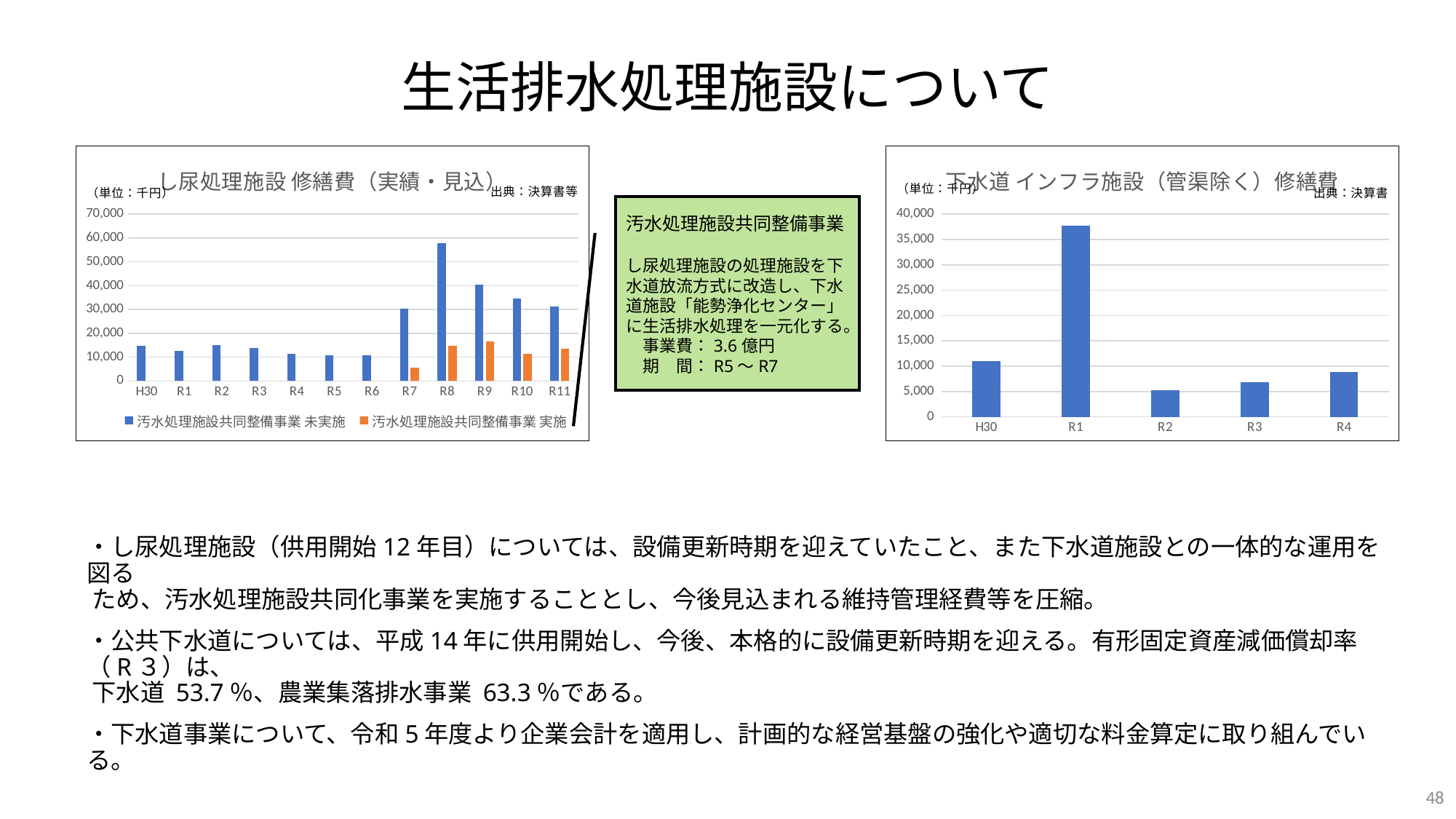
In the left chart (し尿処理施設 修繕費), is the 実施 value for R7 greater or less than 10,000? less How many categories are shown on the x axis of the left chart (し尿処理施設 修繕費)? 12 How many series does the legend of the left chart (し尿処理施設 修繕費) list? 2 In the left chart (し尿処理施設 修繕費), is the 未実施 value for R8 greater or less than 50,000? greater In the right chart (下水道 インフラ施設（管渠除く）修繕費), is the value for R1 greater or less than 35,000? greater How many categories are shown on the x axis of the right chart (下水道 インフラ施設（管渠除く）修繕費)? 5 In the right chart (下水道 インフラ施設（管渠除く）修繕費), which year has the lowest value? R2 In the left chart (し尿処理施設 修繕費), which year has the highest value for 汚水処理施設共同整備事業 実施? R9 In the left chart (し尿処理施設 修繕費), which year has the highest value for 汚水処理施設共同整備事業 未実施? R8 In the right chart (下水道 インフラ施設（管渠除く）修繕費), which year has the highest value? R1 What kind of chart is the left chart titled し尿処理施設 修繕費（実績・見込）? bar chart In the left chart (し尿処理施設 修繕費), what colour are the bars for 汚水処理施設共同整備事業 実施? orange